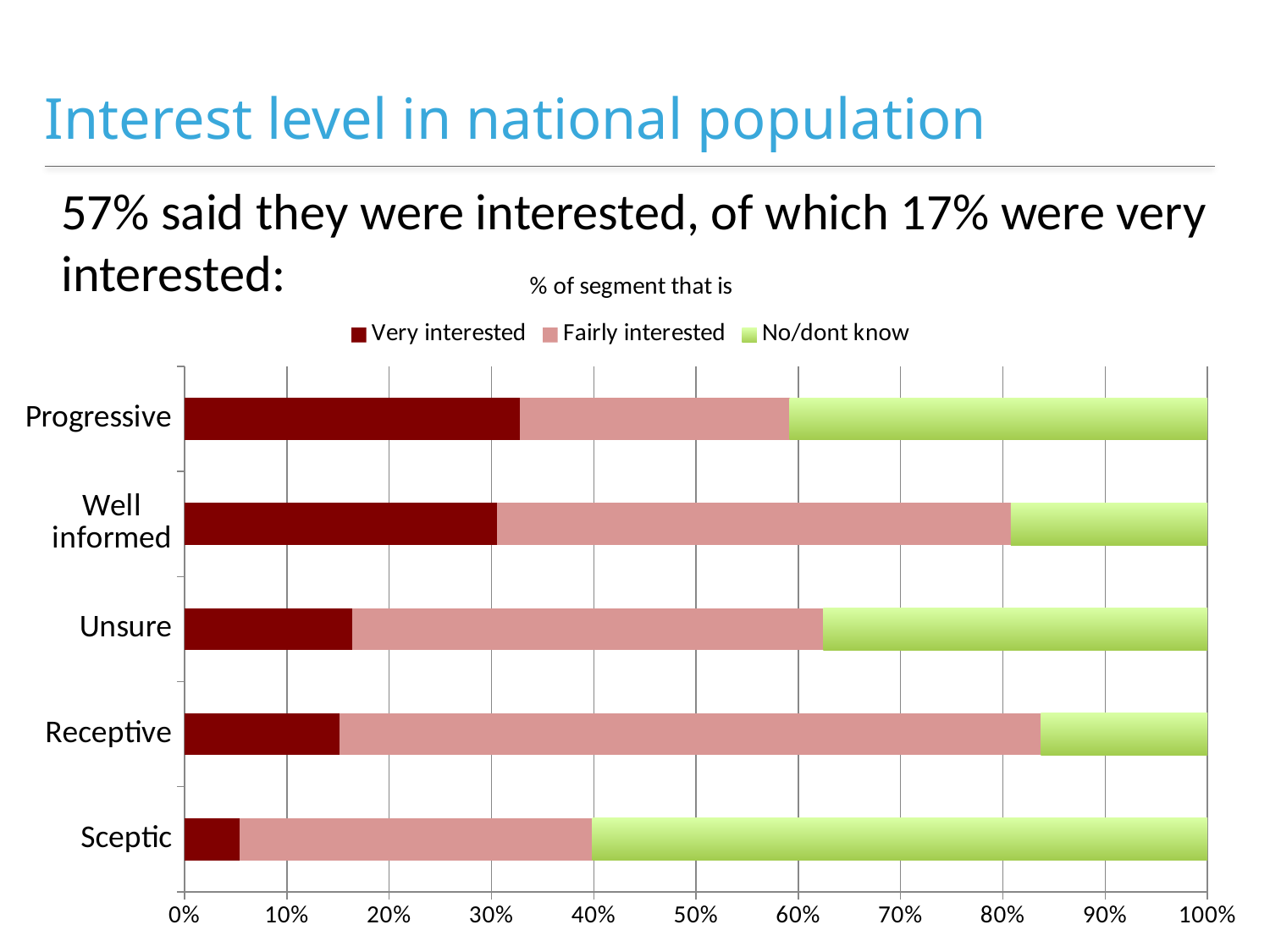
How many series does the legend list? 3 What is the total of the stacked bar for Receptive? 100% What is the title of the chart? % of segment that is Which has the larger Very interested share, Progressive or Sceptic? Progressive How many segments (categories) are plotted on the chart? 5 What kind of chart is shown on the slide? Stacked bar chart Is the Very interested value for Progressive greater or less than 30%? greater Which segment has the smallest Very interested share? Sceptic Which segment has the largest No/dont know share? Sceptic Is the Very interested value for Sceptic greater or less than 10%? less Is the No/dont know value for Sceptic greater or less than 50%? greater Which series is shown in dark red in the legend? Very interested